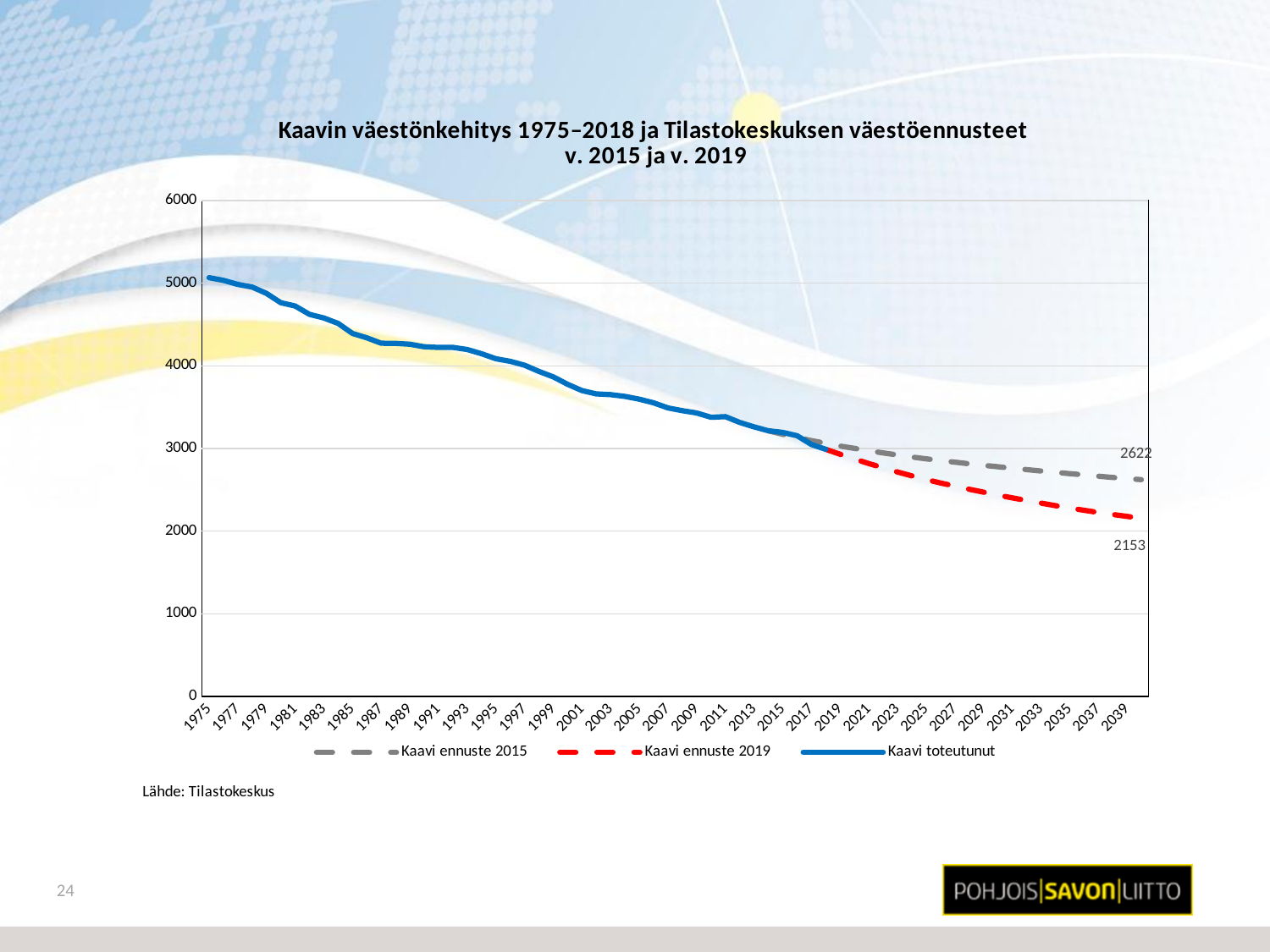
How many series does the legend list? 3 What is the difference between the final labelled values of Kaavi ennuste 2015 (2622) and Kaavi ennuste 2019 (2153)? 469 What kind of chart is shown on the slide? line chart Which forecast series ends at a higher value, Kaavi ennuste 2015 or Kaavi ennuste 2019? Kaavi ennuste 2015 What colour is the Kaavi toteutunut line? blue What is the final labelled value of the Kaavi ennuste 2015 series? 2622 What is the highest value shown on the vertical axis? 6000 Is the value of Kaavi toteutunut in 2005 greater or less than 4000? less Does the Kaavi toteutunut series rise or fall from 1975 to 2018? fall What is the final labelled value of the Kaavi ennuste 2019 series? 2153 Is the value of Kaavi ennuste 2019 in 2039 greater or less than 3000? less Is the value of Kaavi toteutunut in 1975 greater or less than 4000? greater